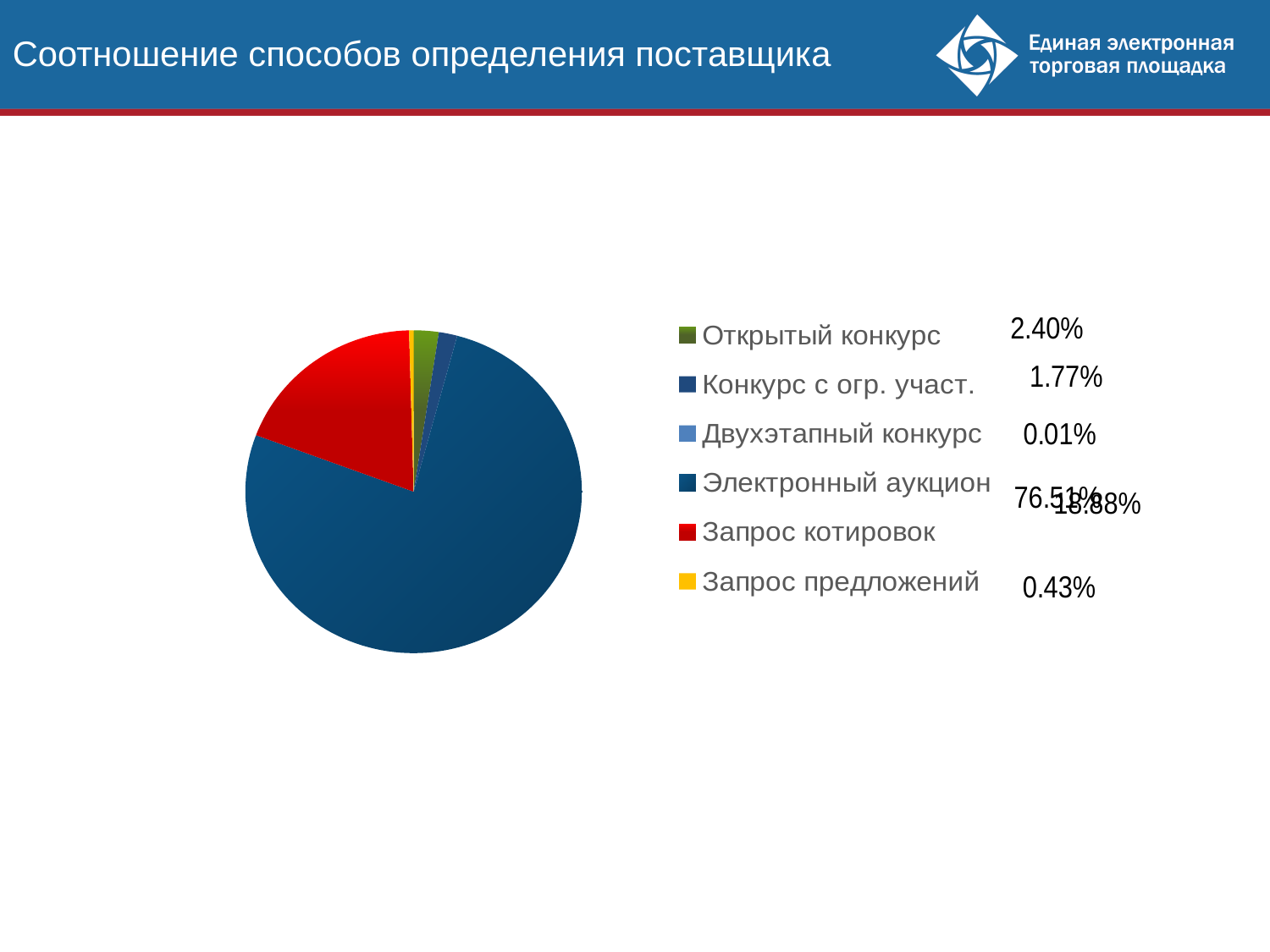
What kind of chart is shown on the slide? pie chart Which is larger, the share for Открытый конкурс or for Конкурс с огр. участ.? Открытый конкурс What is the share for Конкурс с огр. участ.? 1.77% Which category has the smallest share? Двухэтапный конкурс What is the share for Запрос предложений? 0.43% What is the difference between the shares for Открытый конкурс and Конкурс с огр. участ.? 0.63% What is the title of the slide containing the pie chart? Соотношение способов определения поставщика What is the share for Двухэтапный конкурс? 0.01% What is the share for Открытый конкурс? 2.40% How many categories does the pie chart's legend list? 6 Which category has the largest slice of the pie? Электронный аукцион